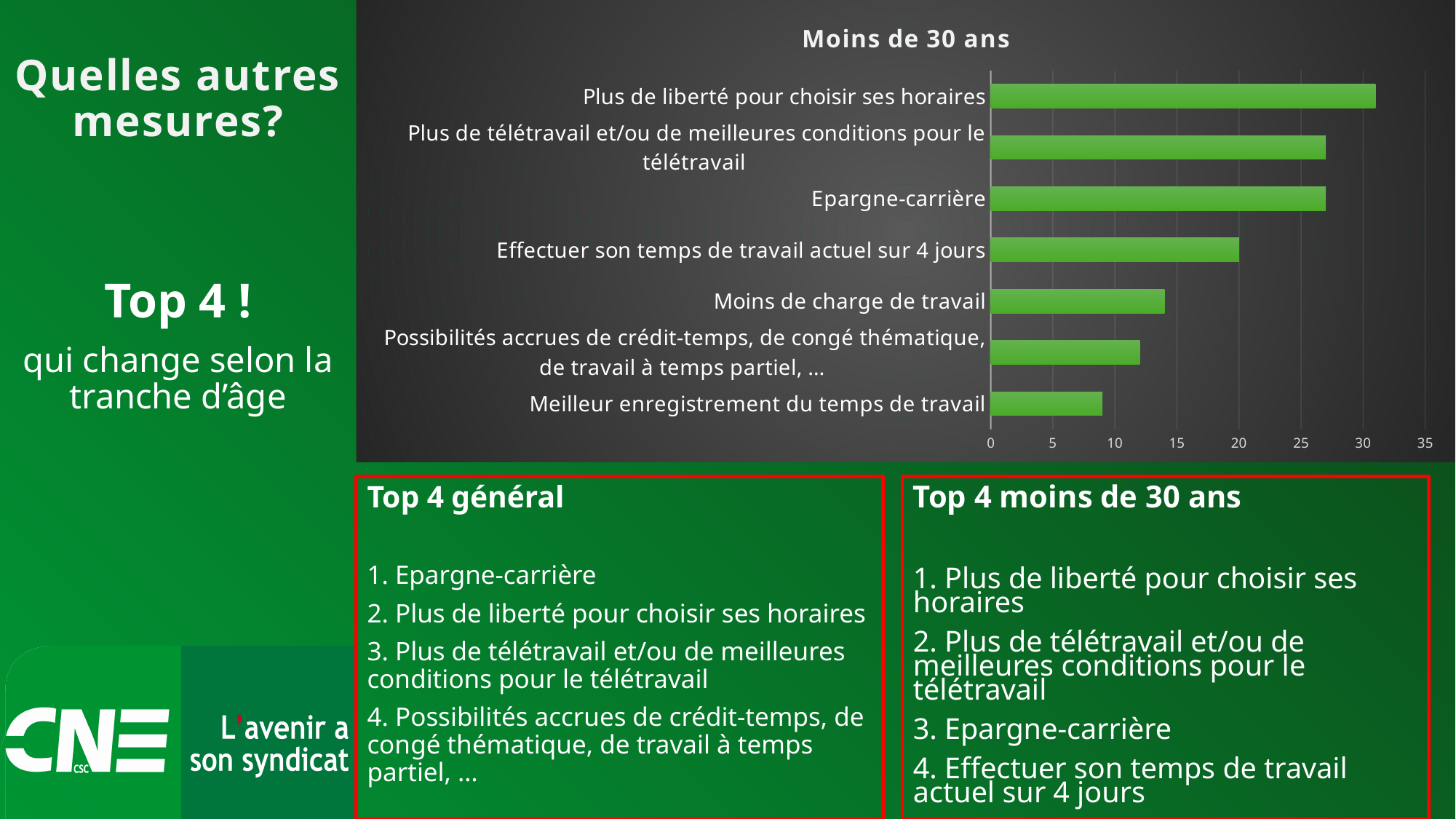
Is the value for "Epargne-carrière" greater or less than 25? greater Is the value for "Moins de charge de travail" greater or less than 15? less Which category has the lowest value in the chart? Meilleur enregistrement du temps de travail What is the title of the chart? Moins de 30 ans Which category has the highest value in the chart? Plus de liberté pour choisir ses horaires Which has the larger value: "Effectuer son temps de travail actuel sur 4 jours" or "Moins de charge de travail"? Effectuer son temps de travail actuel sur 4 jours How many categories are plotted in the chart? 7 Is the value for "Plus de liberté pour choisir ses horaires" greater or less than 30? greater Do the bar values increase or decrease going from the top category to the bottom category? decrease What kind of chart is shown on the slide? Bar chart